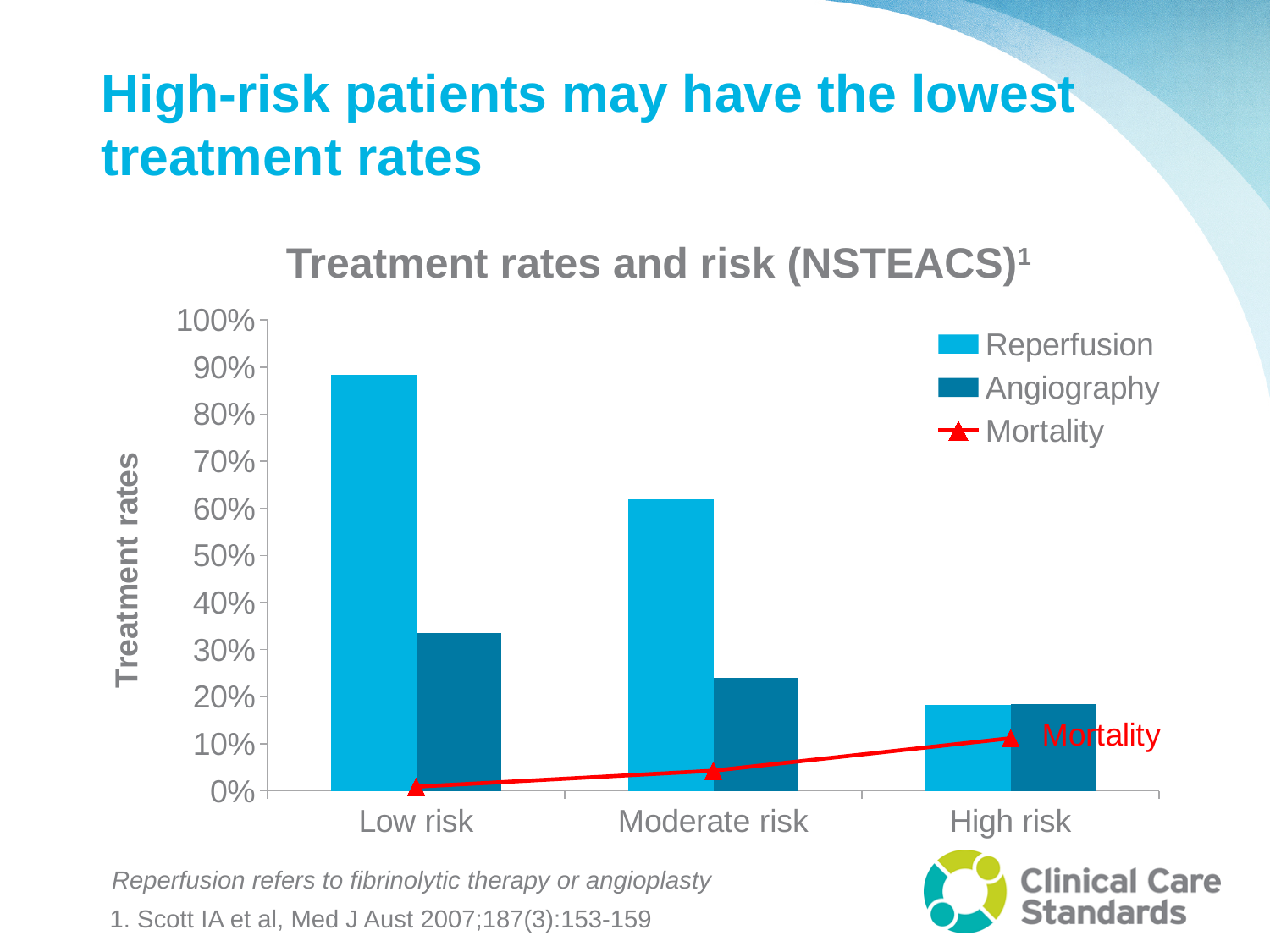
Is the Reperfusion value for Low risk greater or less than 80%? greater What is the title of the chart? Treatment rates and risk (NSTEACS) Which risk category has the lowest Reperfusion rate? High risk Does the Mortality line rise or fall from Low risk to High risk? Rises What kind of chart is shown on the slide? Bar chart with a line Is the Angiography value for Moderate risk greater or less than 30%? less Which risk category has the highest Angiography rate? Low risk How many series does the legend list? 3 For Low risk, which is larger: Reperfusion or Angiography? Reperfusion Which risk category has the highest Reperfusion rate? Low risk Is the Reperfusion value for Moderate risk greater or less than 50%? greater How many risk categories are shown on the x axis? 3